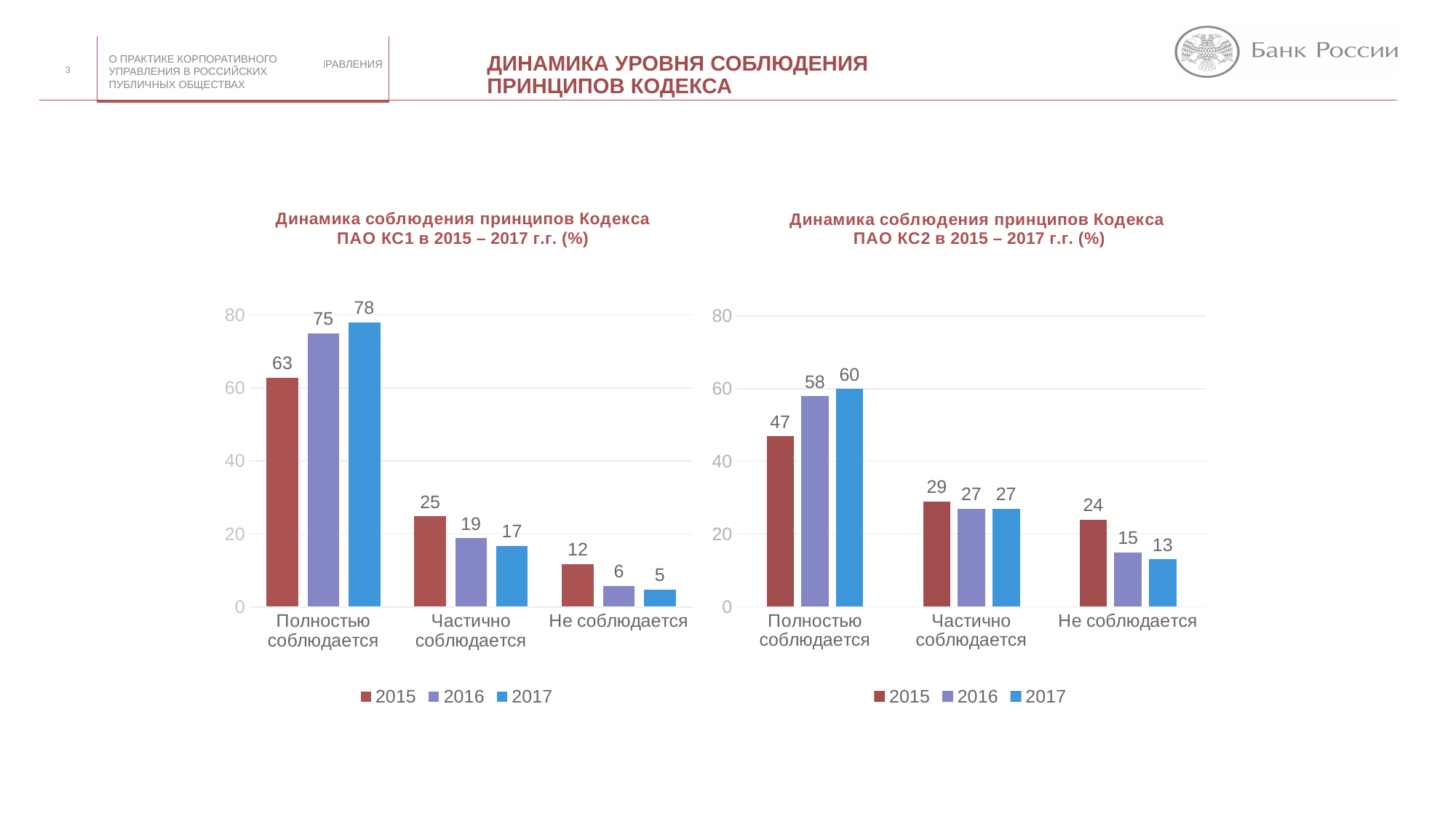
In the right chart (ПАО КС2), which is larger for 'Частично соблюдается': the 2015 value or the 2017 value? 2015 In the left chart (ПАО КС1), do the values for 'Полностью соблюдается' rise or fall from 2015 to 2017? Rise In the right chart (ПАО КС2), how many categories are shown on the x axis? 3 In the right chart (ПАО КС2), what is the difference between the 2015 and 2017 values for 'Не соблюдается'? 11 In the left chart (ПАО КС1), what is the value for 2017 in the 'Полностью соблюдается' category? 78 In the right chart (ПАО КС2), which category has the highest value for 2016? Полностью соблюдается In the right chart (ПАО КС2), what is the value for 2015 in the 'Не соблюдается' category? 24 In the left chart (ПАО КС1), how many series does the legend list? 3 In the left chart (ПАО КС1), which category has the lowest value for 2017? Не соблюдается In the right chart (ПАО КС2), which colour represents 2017 in the legend? Blue In the left chart (ПАО КС1), what is the difference between the 2017 and 2015 values for 'Полностью соблюдается'? 15 What kind of chart is the left chart (ПАО КС1)? Bar chart